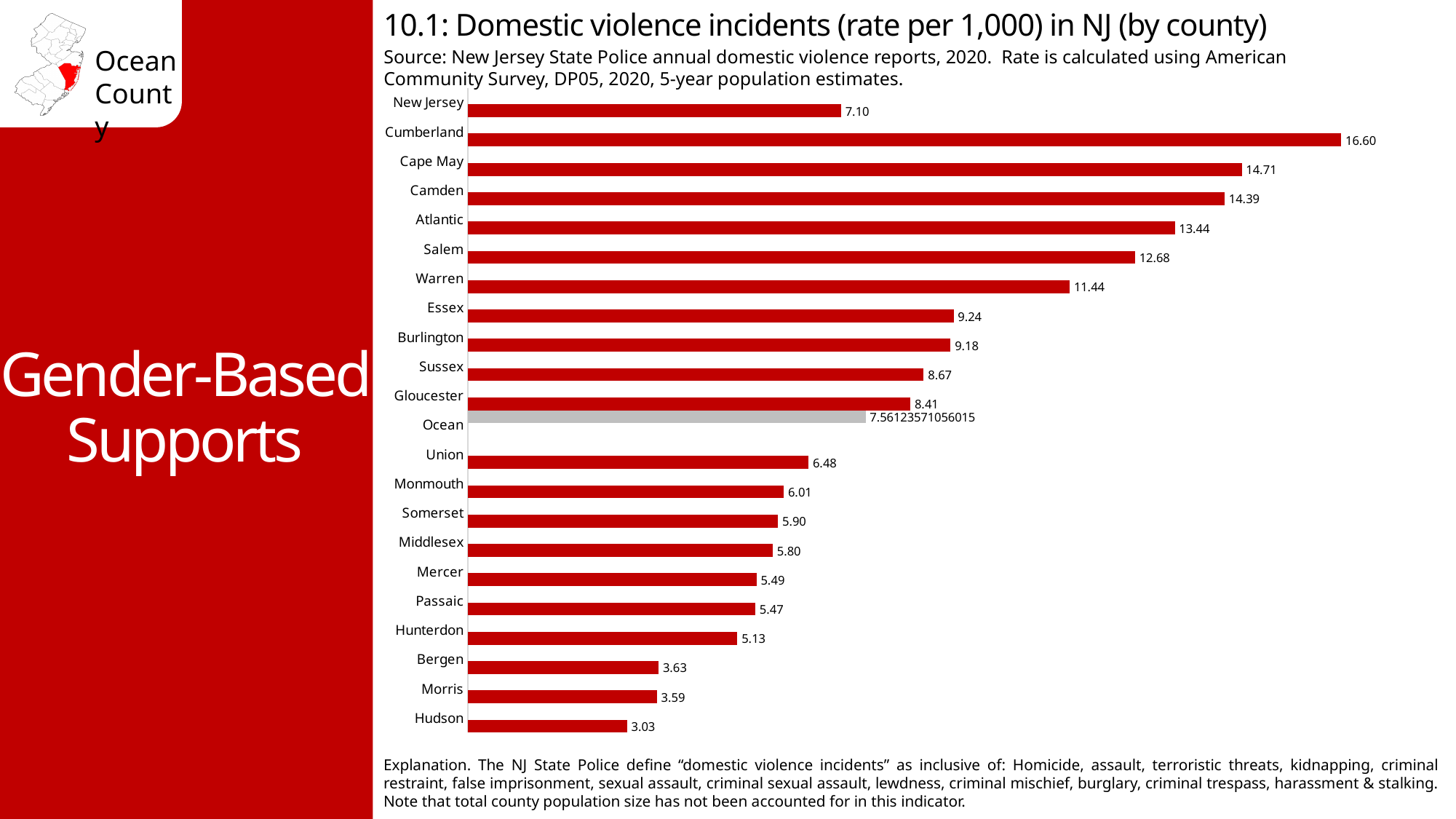
What is the domestic violence incident rate per 1,000 for Hudson? 3.03 What is the domestic violence incident rate per 1,000 for Cumberland? 16.60 What is the rate shown for New Jersey as a whole? 7.10 Which county's bar is coloured grey instead of red? Ocean What is the rate shown for Camden? 14.39 What is the difference between the rates for Atlantic and Salem? 0.76 What type of chart is used on this slide? Bar chart Which county has the highest domestic violence incident rate? Cumberland Which county has the lowest domestic violence incident rate? Hudson How many bars (categories) are shown in the chart? 22 What is the difference between the rates for Cumberland and Cape May? 1.89 Which has a higher rate, Warren or Essex? Warren